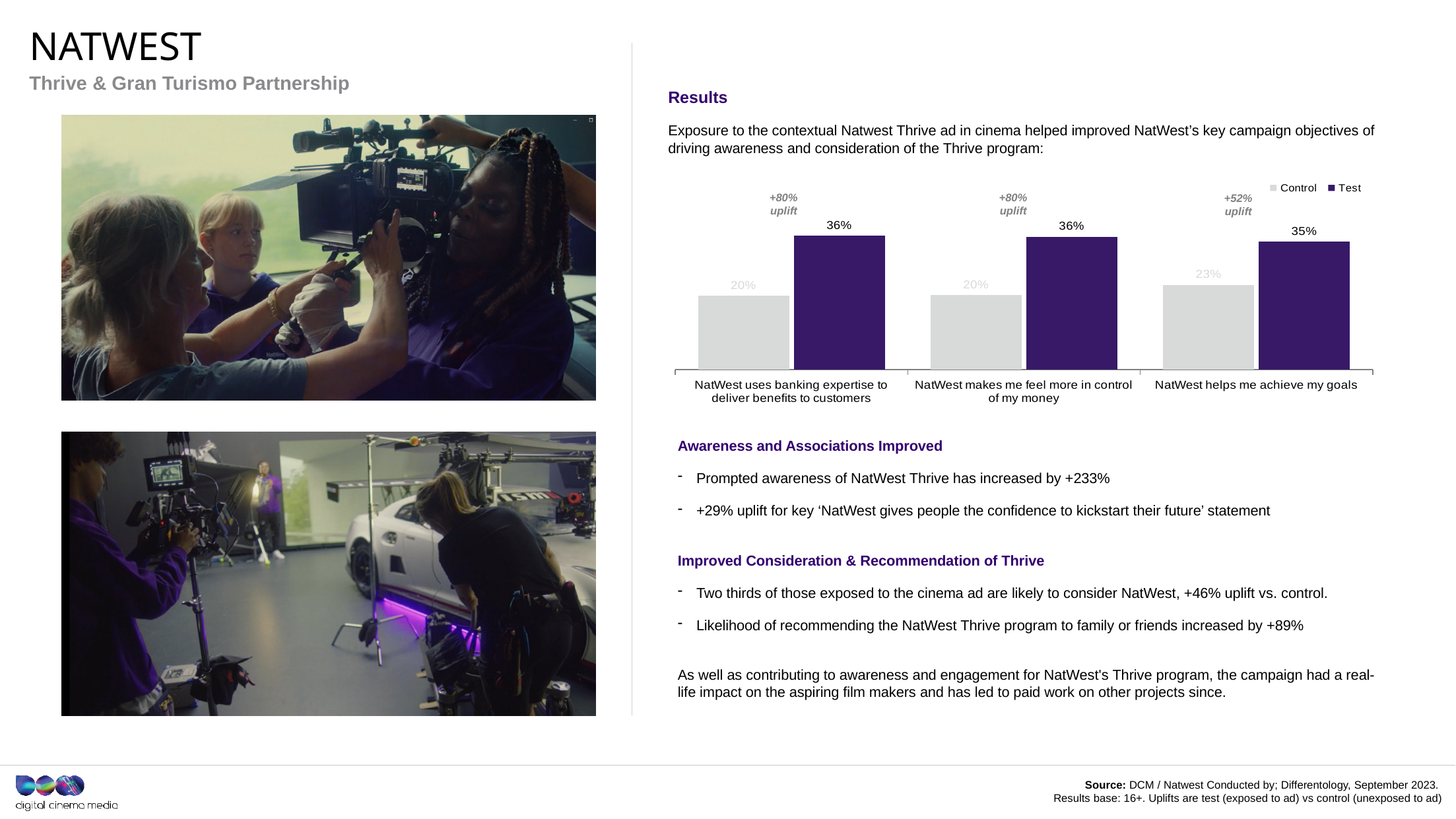
What is the Test value for "NatWest helps me achieve my goals"? 35% Is the Test value or the Control value larger for "NatWest uses banking expertise to deliver benefits to customers"? Test What kind of chart is shown on the slide? Bar chart What is the difference between the Test and Control values for "NatWest makes me feel more in control of my money"? 16% What is the Control value for "NatWest makes me feel more in control of my money"? 20% Which category has the lowest Test value? NatWest helps me achieve my goals What is the Control value for "NatWest helps me achieve my goals"? 23% How many categories are shown on the chart? 3 What is the Test value for "NatWest uses banking expertise to deliver benefits to customers"? 36% How many series does the chart legend list? 2 What is the difference between the Test and Control values for "NatWest helps me achieve my goals"? 12% Which category has the highest Control value? NatWest helps me achieve my goals